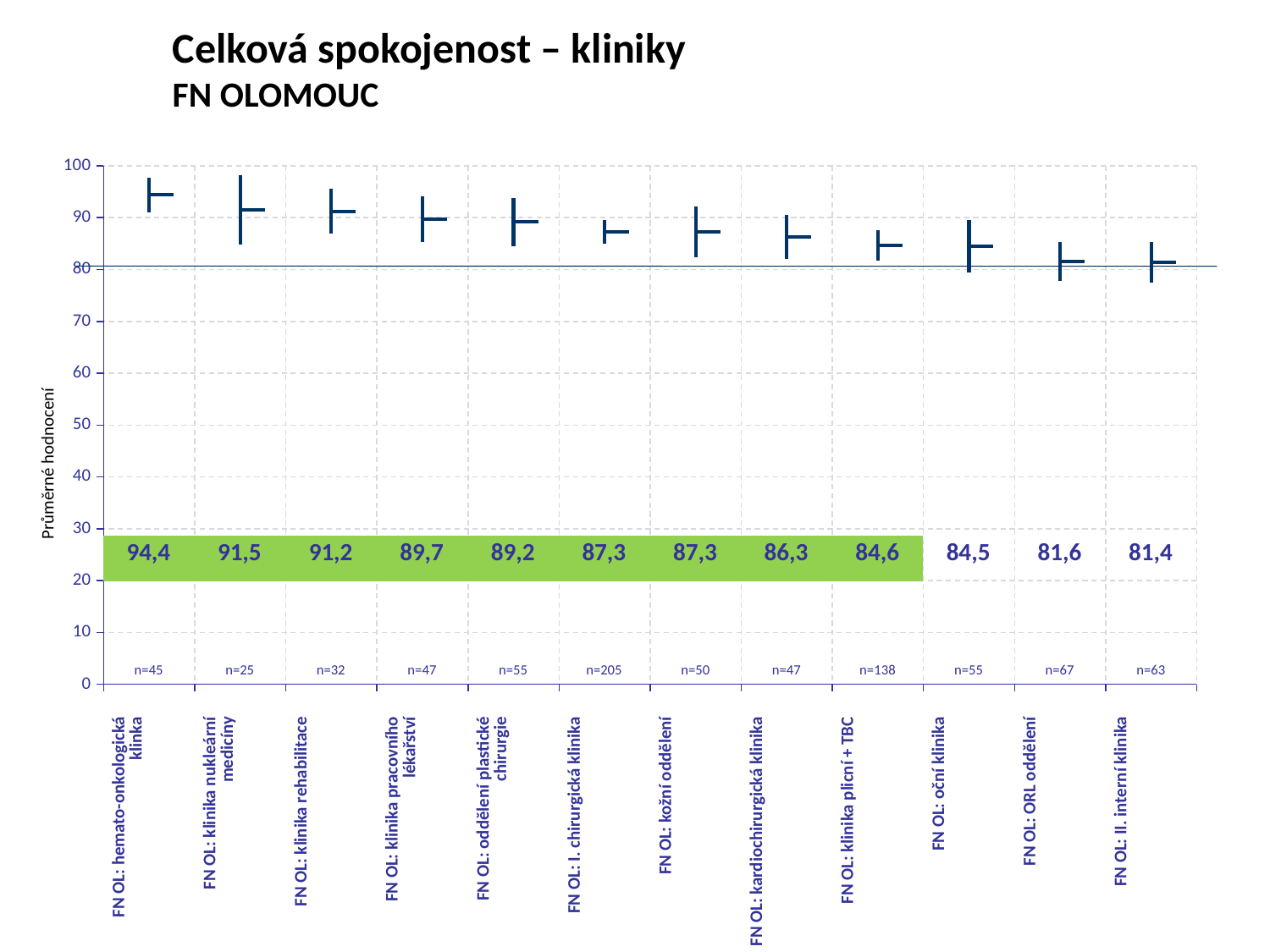
What is the difference between the average ratings of FN OL: hemato-onkologická klinika and FN OL: II. interní klinika? 13,0 What is the average rating (průměrné hodnocení) for FN OL: hemato-onkologická klinika? 94,4 What is the average rating for FN OL: klinika plicní + TBC? 84,6 Which has a higher average rating, FN OL: oddělení plastické chirurgie or FN OL: kardiochirurgická klinika? FN OL: oddělení plastické chirurgie How many clinics are shown on the chart? 12 What is the sample size (n) shown for FN OL: I. chirurgická klinika? n=205 What is the title of the chart? Celková spokojenost – kliniky FN OLOMOUC What is the difference between the average ratings of FN OL: klinika nukleární medicíny and FN OL: klinika rehabilitace? 0,3 Do the average ratings rise or fall from left to right along the x axis? fall What is the average rating for FN OL: ORL oddělení? 81,6 Which clinic has the lowest average rating? FN OL: II. interní klinika Which clinic has the highest average rating? FN OL: hemato-onkologická klinika